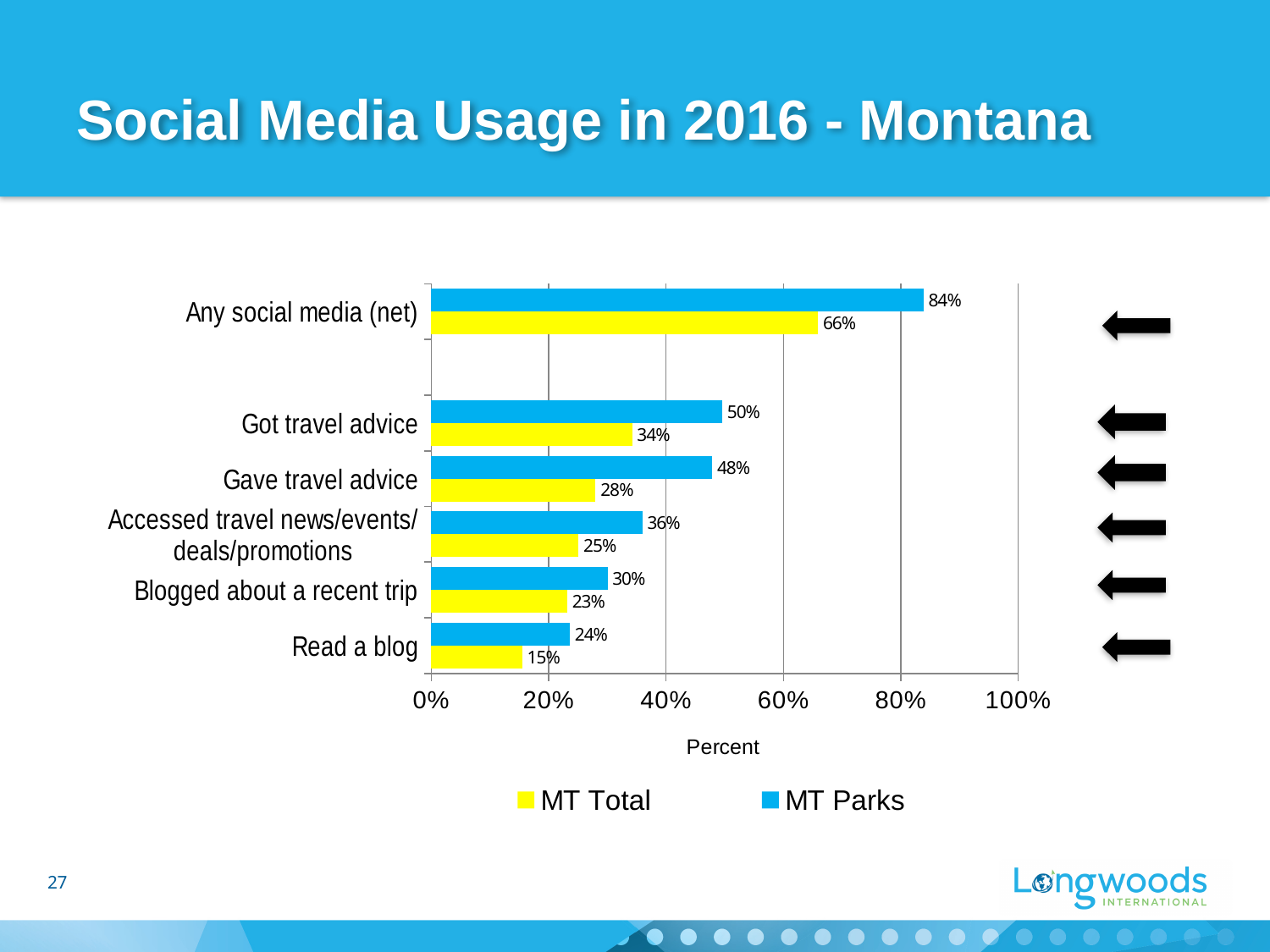
What is the MT Parks value for Blogged about a recent trip? 30% Which is larger for Accessed travel news/events/deals/promotions: MT Total or MT Parks? MT Parks What is the MT Total value for Got travel advice? 34% How many series does the legend list? 2 What is the MT Total value for Read a blog? 15% Which category has the highest MT Parks value? Any social media (net) Which category has the lowest MT Total value? Read a blog What is the difference between the MT Parks and MT Total values for Gave travel advice? 20% How many categories are shown on the chart? 6 What is the label of the horizontal axis? Percent What is the MT Parks value for Any social media (net)? 84% What kind of chart is shown on the slide? Bar chart